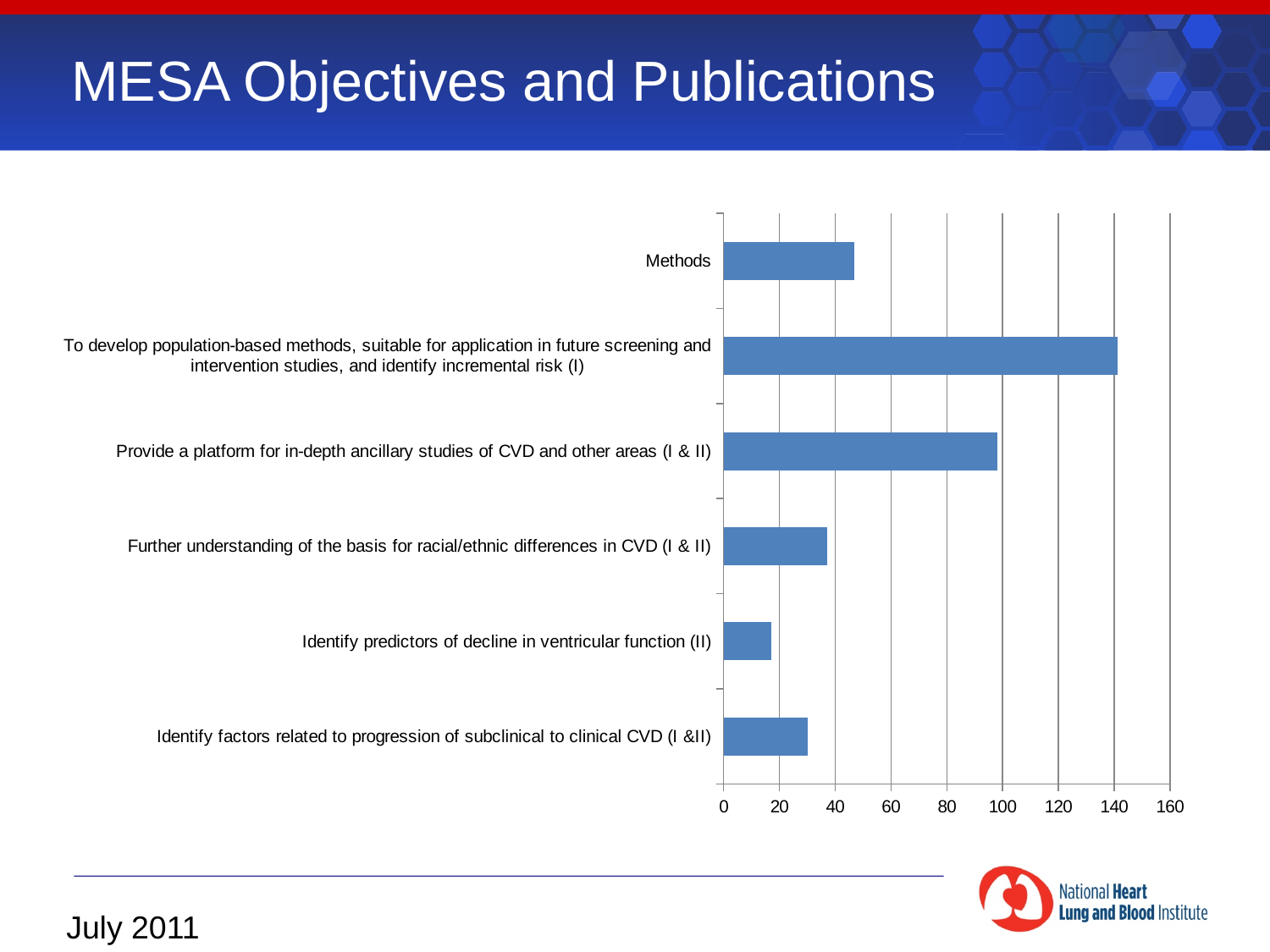
Is the value for Methods greater or less than 40? greater Is the value for 'Identify factors related to progression of subclinical to clinical CVD (I &II)' greater or less than 20? greater What is the highest tick value shown on the horizontal axis? 160 What kind of chart is shown on the slide? bar chart Is the value for 'Identify predictors of decline in ventricular function (II)' greater or less than 40? less Which is larger: the value for Methods or the value for 'Further understanding of the basis for racial/ethnic differences in CVD (I & II)'? Methods Which category has the highest value? To develop population-based methods, suitable for application in future screening and intervention studies, and identify incremental risk (I) Which is larger: the value for 'Provide a platform for in-depth ancillary studies of CVD and other areas (I & II)' or the value for Methods? Provide a platform for in-depth ancillary studies of CVD and other areas (I & II) Which category has the lowest value? Identify predictors of decline in ventricular function (II) How many categories (bars) does the chart show? 6